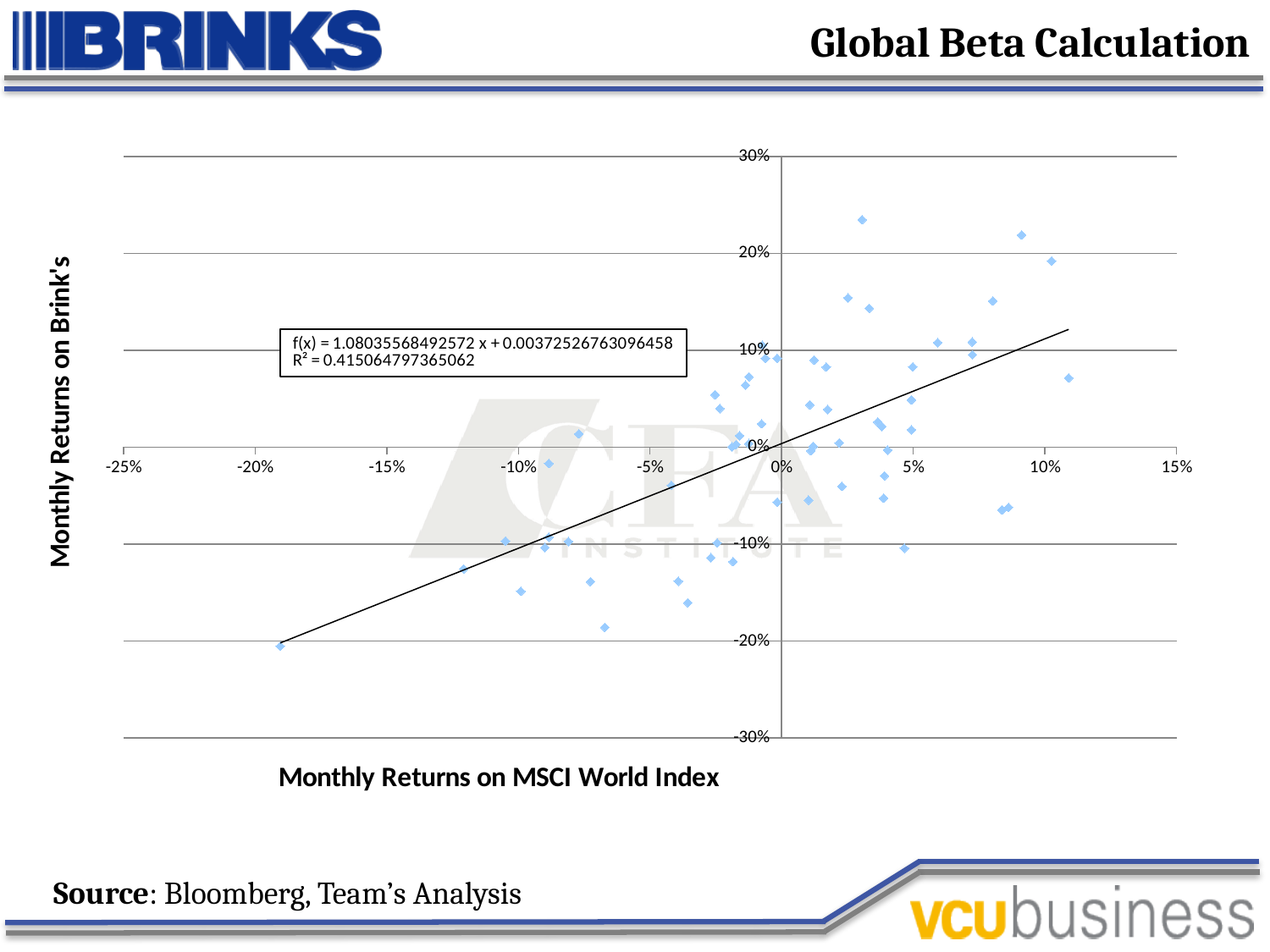
Is the y value of the lowest plotted point (near x = -19%) greater or less than -15%? less What is the label of the x axis? Monthly Returns on MSCI World Index What kind of chart is shown on the slide? Scatter chart What R² value is printed on the chart? 0.415064797365062 What is the label of the y axis? Monthly Returns on Brink's What is the slope of the fitted trendline shown in the equation box? 1.08035568492572 What is the intercept of the fitted trendline shown in the equation box? 0.00372526763096458 Does the trendline rise or fall as the x axis increases? Rises Is the y value of the highest plotted point greater or less than 20%? greater What is the highest value shown on the y axis? 30% What is the title of the slide's chart? Global Beta Calculation What is the lowest value shown on the x axis? -25%